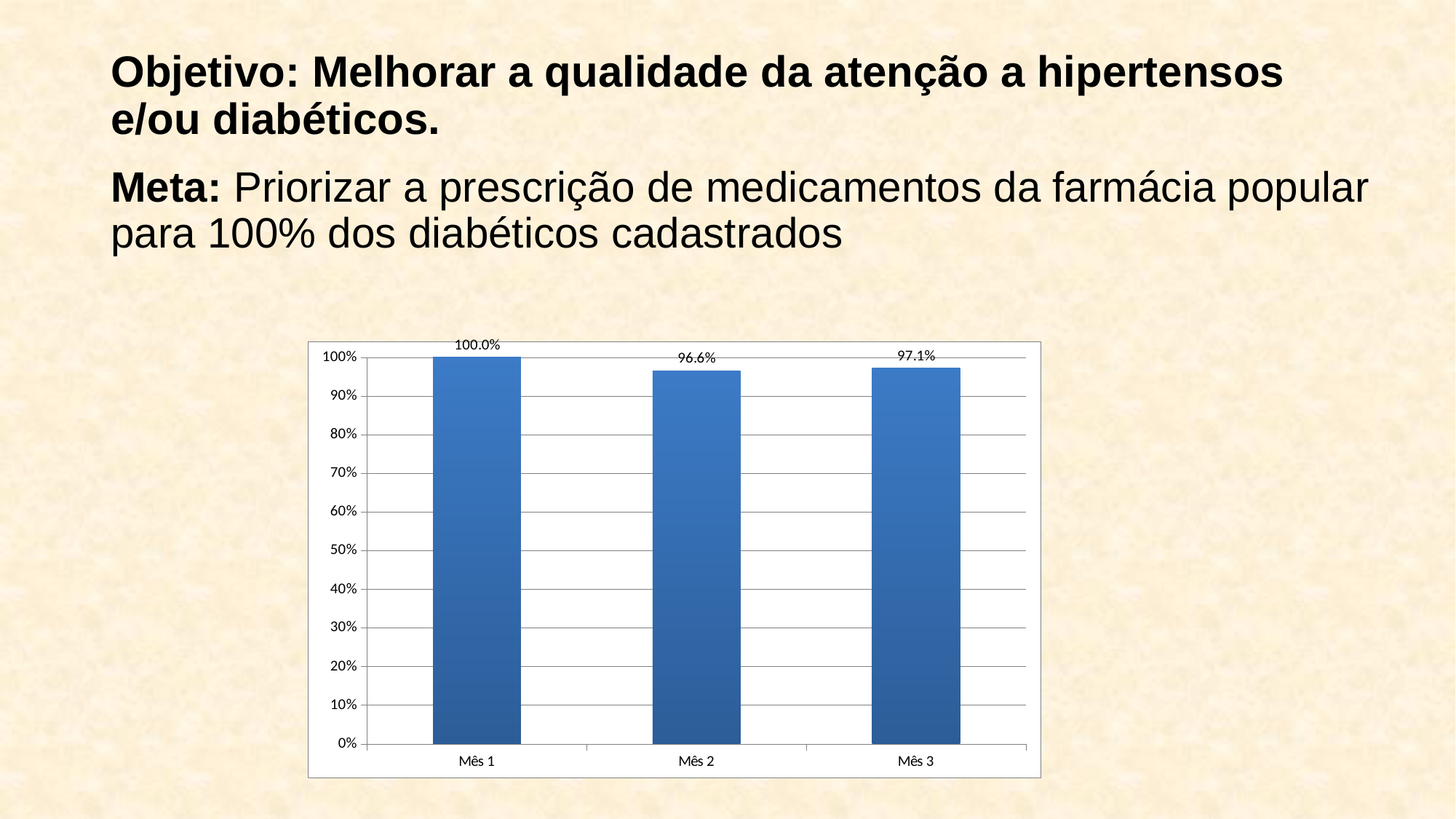
What is the difference between the values for Mês 3 and Mês 2? 0.5% Which month has the highest value? Mês 1 Which is larger, the value for Mês 1 or the value for Mês 3? Mês 1 What is the value for Mês 1? 100.0% What colour are the bars in the chart? blue What kind of chart is shown on the slide? bar chart What is the value for Mês 2? 96.6% Is the value for Mês 2 greater or less than 90%? greater Which month has the lowest value? Mês 2 What is the value for Mês 3? 97.1% What is the difference between the values for Mês 1 and Mês 2? 3.4% How many months are shown on the x axis? 3